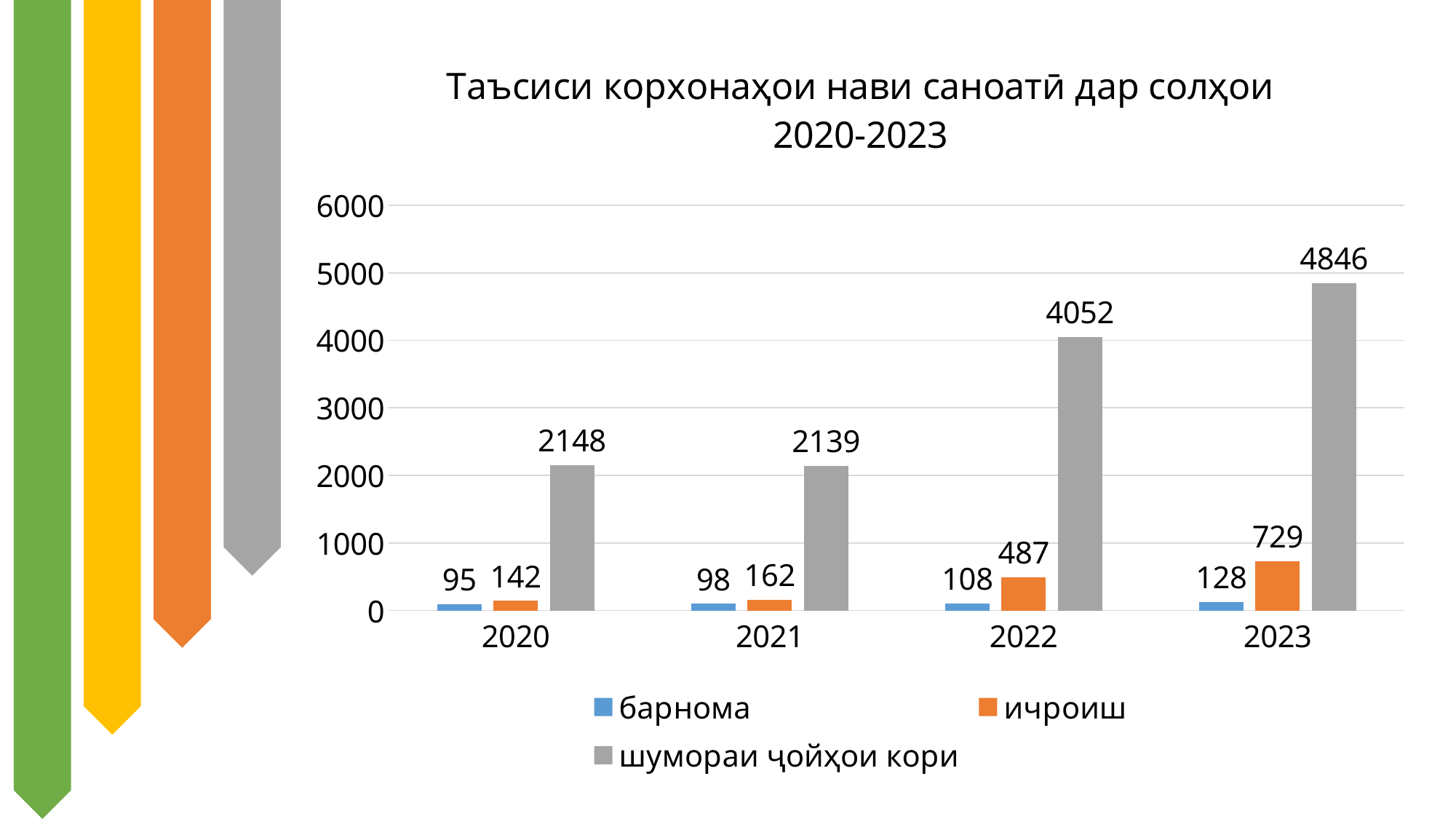
Which is larger: шумораи ҷойҳои кори in 2020 or in 2021? 2020 How many series does the legend list? 3 What kind of chart is shown on the slide? bar chart What is the difference between иҷроиш in 2023 and иҷроиш in 2022? 242 Does the value of иҷроиш rise or fall from 2020 to 2023? rise Which year has the lowest value for барнома? 2020 How many years are shown on the x axis? 4 Is the value for шумораи ҷойҳои кори in 2022 greater or less than 3000? greater What is the value of иҷроиш for 2022? 487 What is the value of барнома for 2020? 95 Which year has the highest value for шумораи ҷойҳои кори? 2023 What is the value of шумораи ҷойҳои кори for 2023? 4846